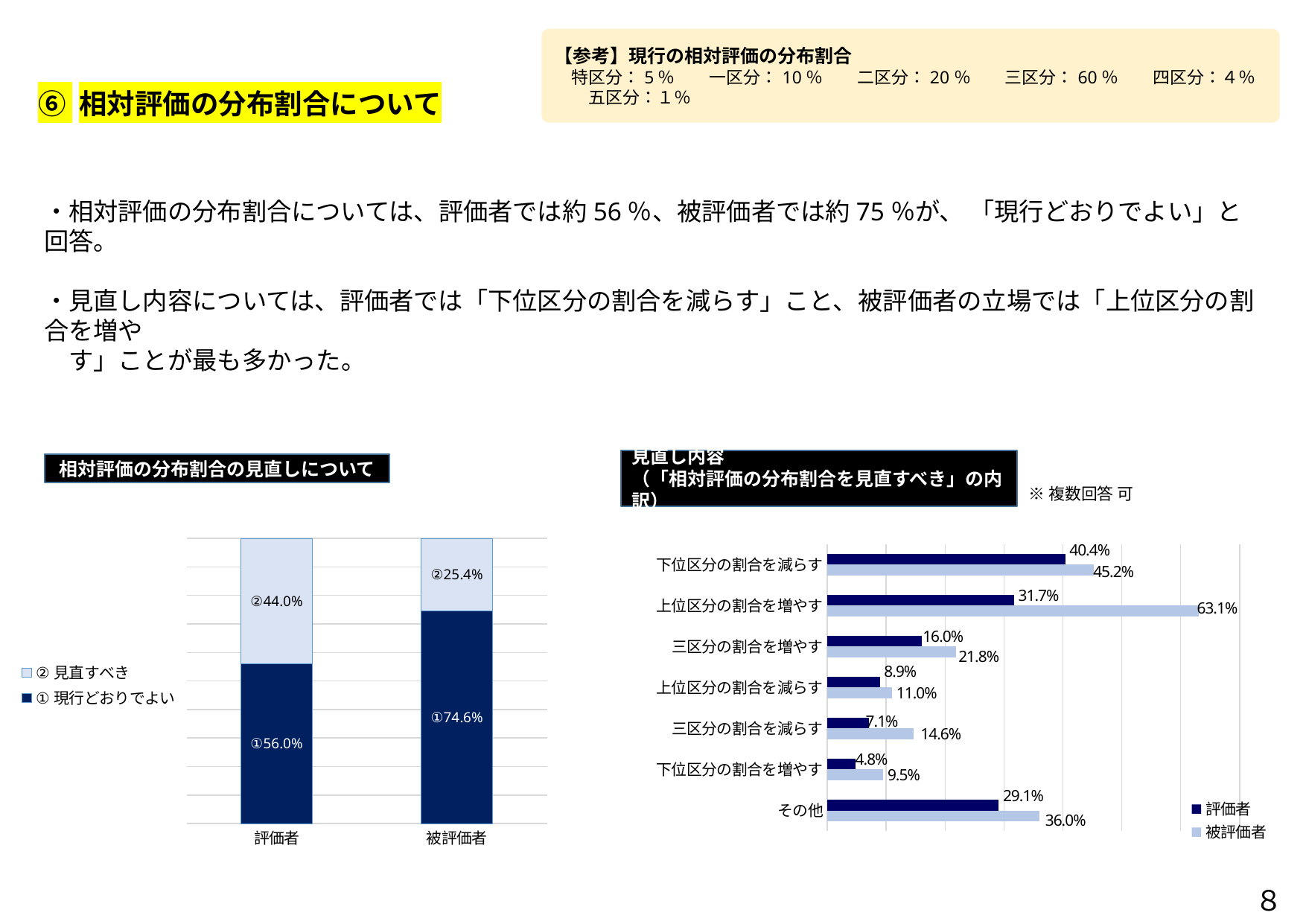
In the right chart '見直し内容', what is the value for 被評価者 for '上位区分の割合を増やす'? 63.1% In the left chart '相対評価の分布割合の見直しについて', what is the difference between the '① 現行どおりでよい' values for 被評価者 and 評価者? 18.6% In the right chart '見直し内容', which is larger for '三区分の割合を減らす': the 評価者 value or the 被評価者 value? 被評価者 In the right chart '見直し内容', which category has the lowest value for 被評価者? 下位区分の割合を増やす In the right chart '見直し内容', how many categories are shown? 7 In the right chart '見直し内容', which category has the highest value for 評価者? 下位区分の割合を減らす In the right chart '見直し内容', what is the value for 評価者 for '下位区分の割合を減らす'? 40.4% In the left chart '相対評価の分布割合の見直しについて', what is the value of '② 見直すべき' for 被評価者? 25.4% What kind of chart is the left chart '相対評価の分布割合の見直しについて'? Stacked bar chart In the left chart '相対評価の分布割合の見直しについて', how many series does the legend list? 2 In the left chart '相対評価の分布割合の見直しについて', what is the value of '① 現行どおりでよい' for 評価者? 56.0% In the right chart '見直し内容', what is the difference between the 被評価者 and 評価者 values for '上位区分の割合を増やす'? 31.4%